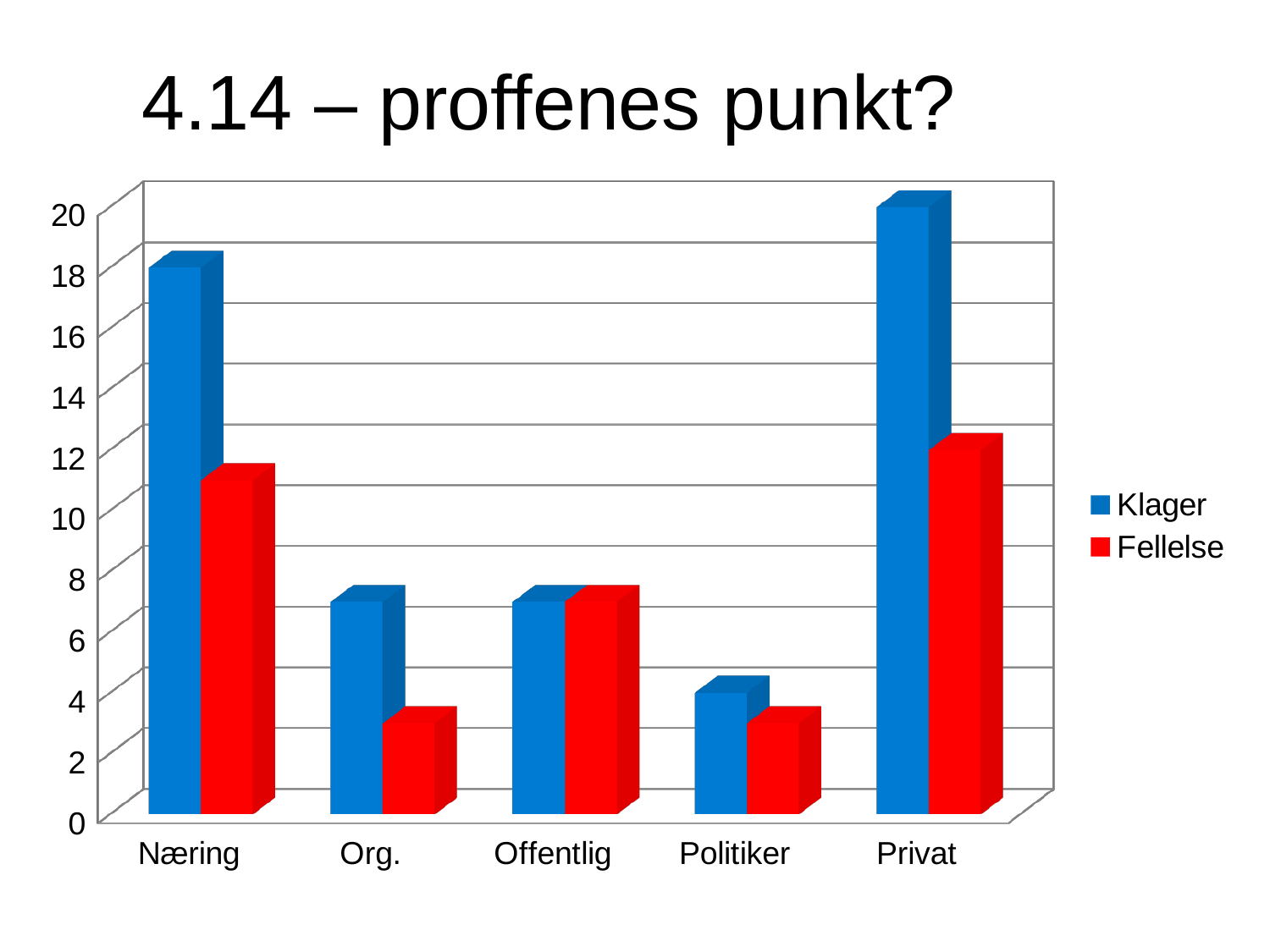
What is the title of the slide? 4.14 – proffenes punkt? Is the Klager value for Næring greater or less than 16? greater Which category has the highest Fellelse value? Privat Is the Fellelse value for Org. greater or less than 6? less How many categories are shown on the x axis? 5 Which category has the highest Klager value? Privat Which is larger, the Klager value for Næring or the Fellelse value for Næring? Klager How many series does the legend list? 2 Which category has the lowest Klager value? Politiker What kind of chart is shown on the slide? bar chart Is the Klager value for Privat greater or less than 18? greater Which is larger, the Klager value for Politiker or the Klager value for Org.? Org.